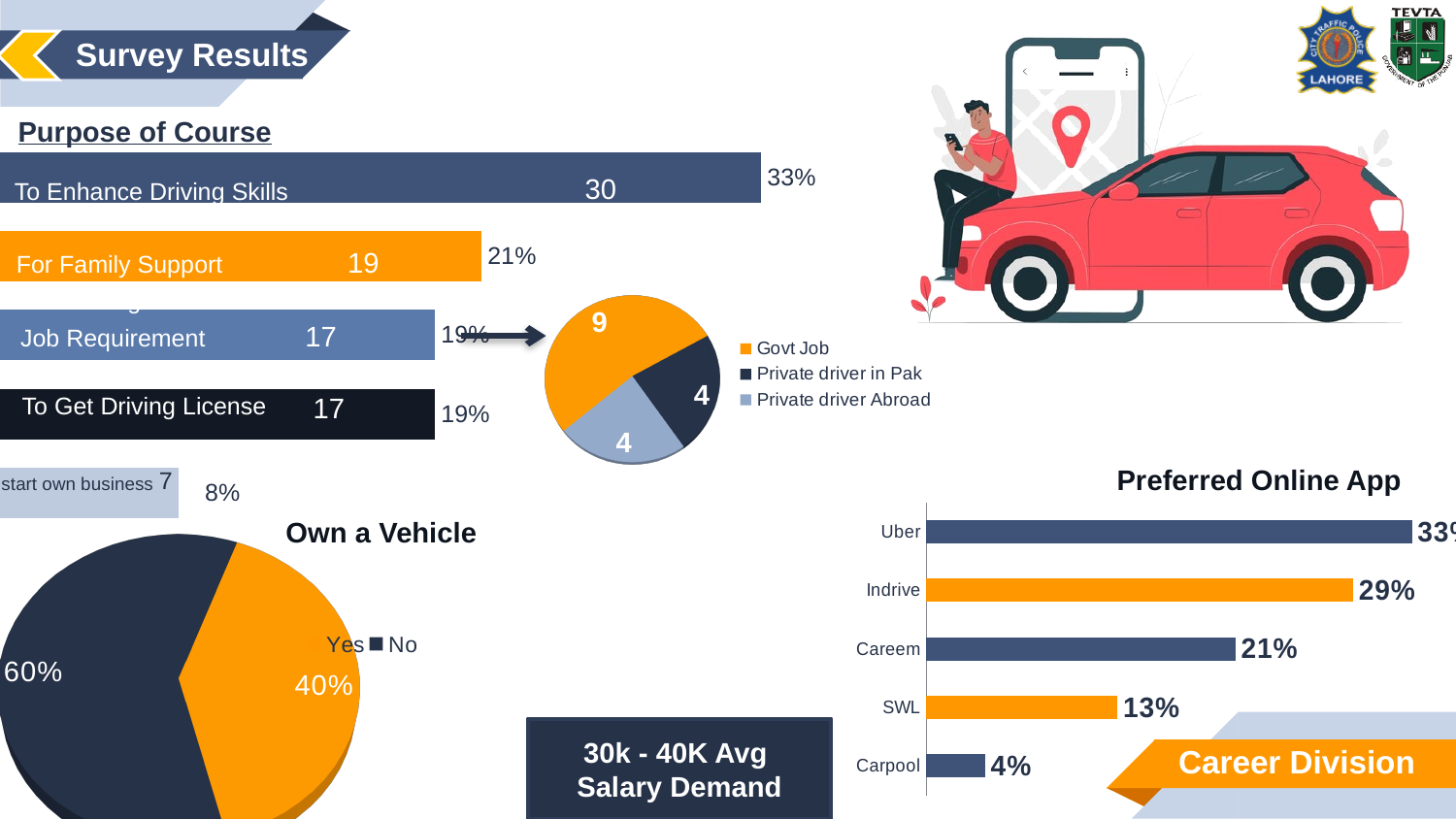
In the Own a Vehicle pie chart, what share is shown for No? 60% In the Purpose of Course chart, what percentage is shown for For Family Support? 21% In the Preferred Online App chart, which app has the highest value? Uber In the Purpose of Course chart, what is the difference between To Enhance Driving Skills and For Family Support? 11 How many entries does the legend of the small pie chart next to Job Requirement list? 3 What kind of chart is the Preferred Online App chart? Bar chart In the small pie chart next to Job Requirement, what is the value for Govt Job? 9 In the Own a Vehicle pie chart, which is larger, Yes or No? No In the Preferred Online App chart, what is the value for Indrive? 29% How many categories does the Purpose of Course chart show? 5 In the Purpose of Course chart, which purpose has the lowest value? start own business In the Purpose of Course chart, what is the value for To Enhance Driving Skills? 30